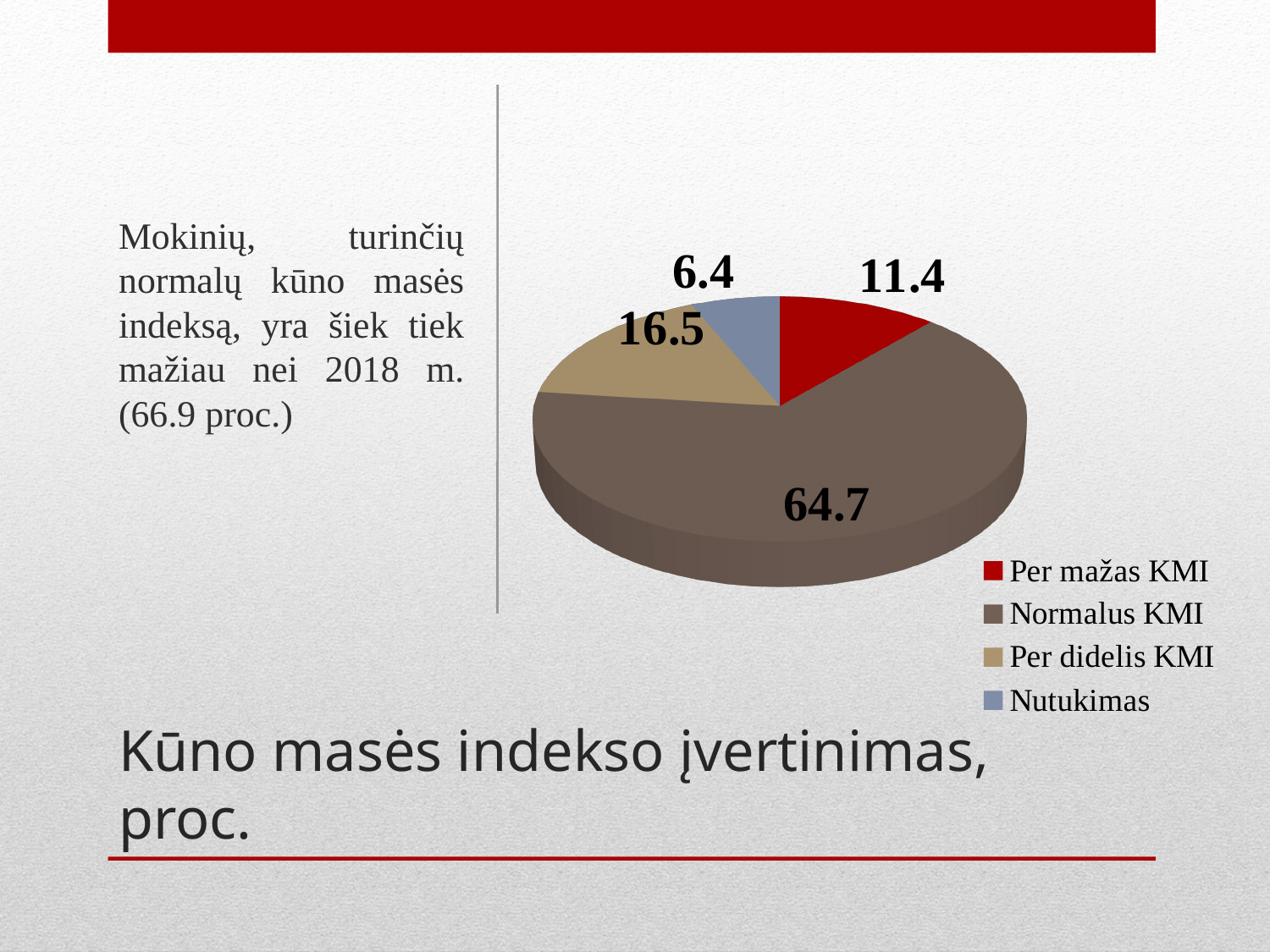
What is the value for Normalus KMI? 64.7 Which colour represents Per mažas KMI in the legend? red What is the value for Per didelis KMI? 16.5 What is the difference between the values for Normalus KMI and Per didelis KMI? 48.2 What is the value for Nutukimas? 6.4 What is the difference between the values for Per didelis KMI and Per mažas KMI? 5.1 Which category has the smallest slice of the pie? Nutukimas How many categories does the pie chart have? 4 What is the value for Per mažas KMI? 11.4 Which category has the largest slice of the pie? Normalus KMI Which is larger, the value for Per mažas KMI or the value for Nutukimas? Per mažas KMI What type of chart is shown on the slide? pie chart